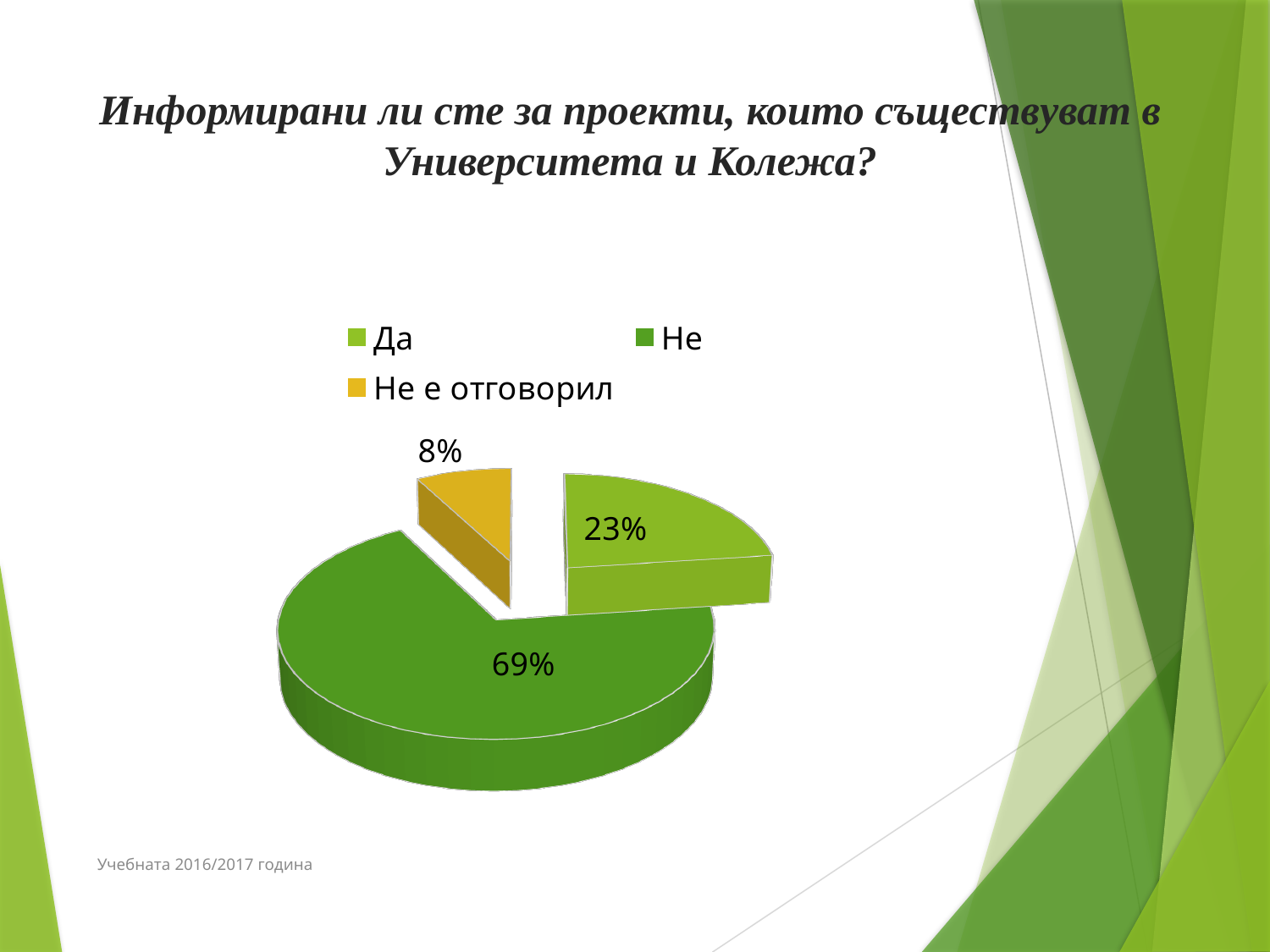
What is the combined share of "Да" and "Не е отговорил"? 31% Which category has the largest share of the pie? Не What percentage of respondents answered "Да"? 23% How many categories does the pie chart show? 3 Which category has the smallest share of the pie? Не е отговорил What kind of chart is shown on the slide? Pie chart Which is larger, the share for "Да" or the share for "Не е отговорил"? Да What percentage is shown for "Не е отговорил"? 8% What percentage of respondents answered "Не"? 69% What colour is the slice for "Не е отговорил"? Yellow What is the difference in percentage points between "Не" and "Да"? 46 Which academic year is noted at the bottom of the slide? 2016/2017